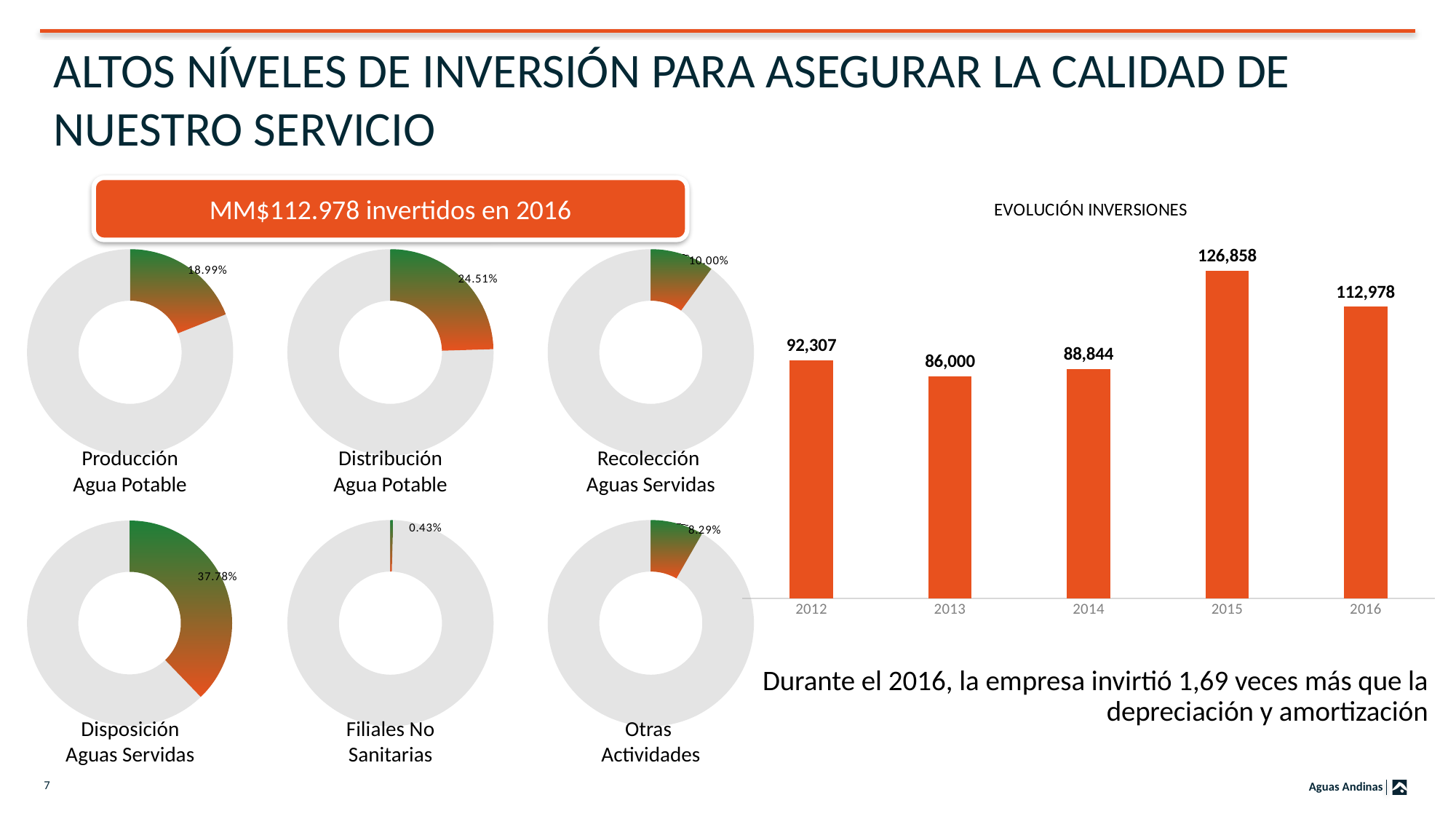
In the EVOLUCIÓN INVERSIONES chart, which year has the highest value? 2015 In the EVOLUCIÓN INVERSIONES chart, what is the value for 2013? 86,000 In the EVOLUCIÓN INVERSIONES chart, what is the difference between the values for 2015 and 2016? 13,880 What kind of chart is EVOLUCIÓN INVERSIONES? Bar chart In the EVOLUCIÓN INVERSIONES chart, does the value rise or fall from 2015 to 2016? Fall How many years are shown in the EVOLUCIÓN INVERSIONES chart? 5 In the donut chart labelled Disposición Aguas Servidas, what percentage is shown? 37.78% Among the six donut charts on the left, which category has the largest percentage? Disposición Aguas Servidas In the EVOLUCIÓN INVERSIONES chart, which year has the lowest value? 2013 In the EVOLUCIÓN INVERSIONES chart, what is the value for 2015? 126,858 In the EVOLUCIÓN INVERSIONES chart, which is larger, the value for 2012 or the value for 2014? 2012 In the donut chart labelled Filiales No Sanitarias, what percentage is shown? 0.43%